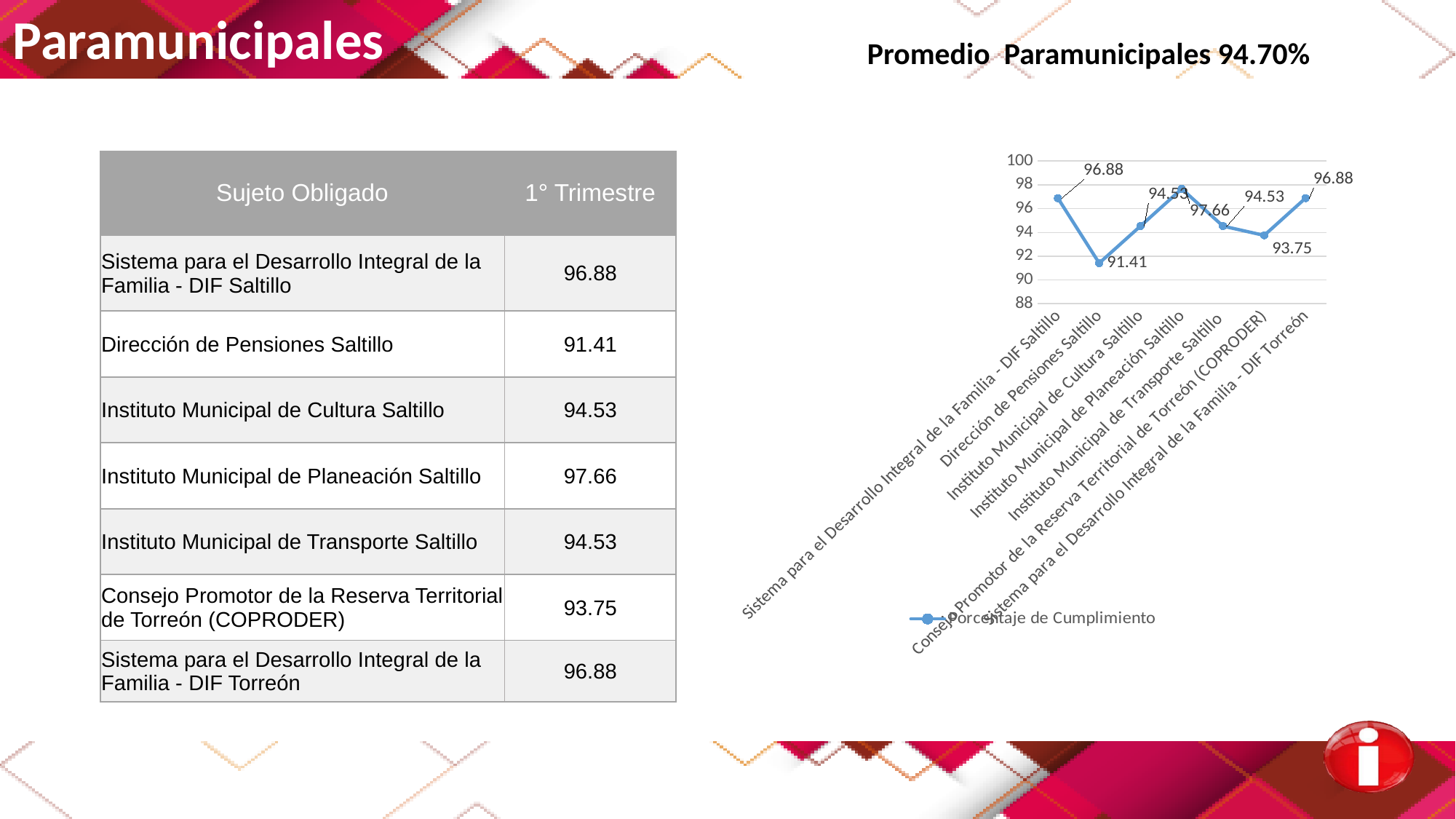
What type of chart is shown on the slide? line chart What is the name of the series shown in the chart legend? Porcentaje de Cumplimiento How many series does the chart legend list? 1 What is the value plotted for Consejo Promotor de la Reserva Territorial de Torreón (COPRODER)? 93.75 What is the value plotted for Dirección de Pensiones Saltillo? 91.41 What is the value plotted for Instituto Municipal de Planeación Saltillo? 97.66 What is the difference between the values for Instituto Municipal de Planeación Saltillo and Dirección de Pensiones Saltillo? 6.25 Which category has the lowest value in the chart? Dirección de Pensiones Saltillo Which is larger: the value for Instituto Municipal de Transporte Saltillo or the value for Consejo Promotor de la Reserva Territorial de Torreón (COPRODER)? Instituto Municipal de Transporte Saltillo What is the value plotted for Instituto Municipal de Cultura Saltillo? 94.53 Which category has the highest value in the chart? Instituto Municipal de Planeación Saltillo How many categories are plotted on the x axis of the chart? 7